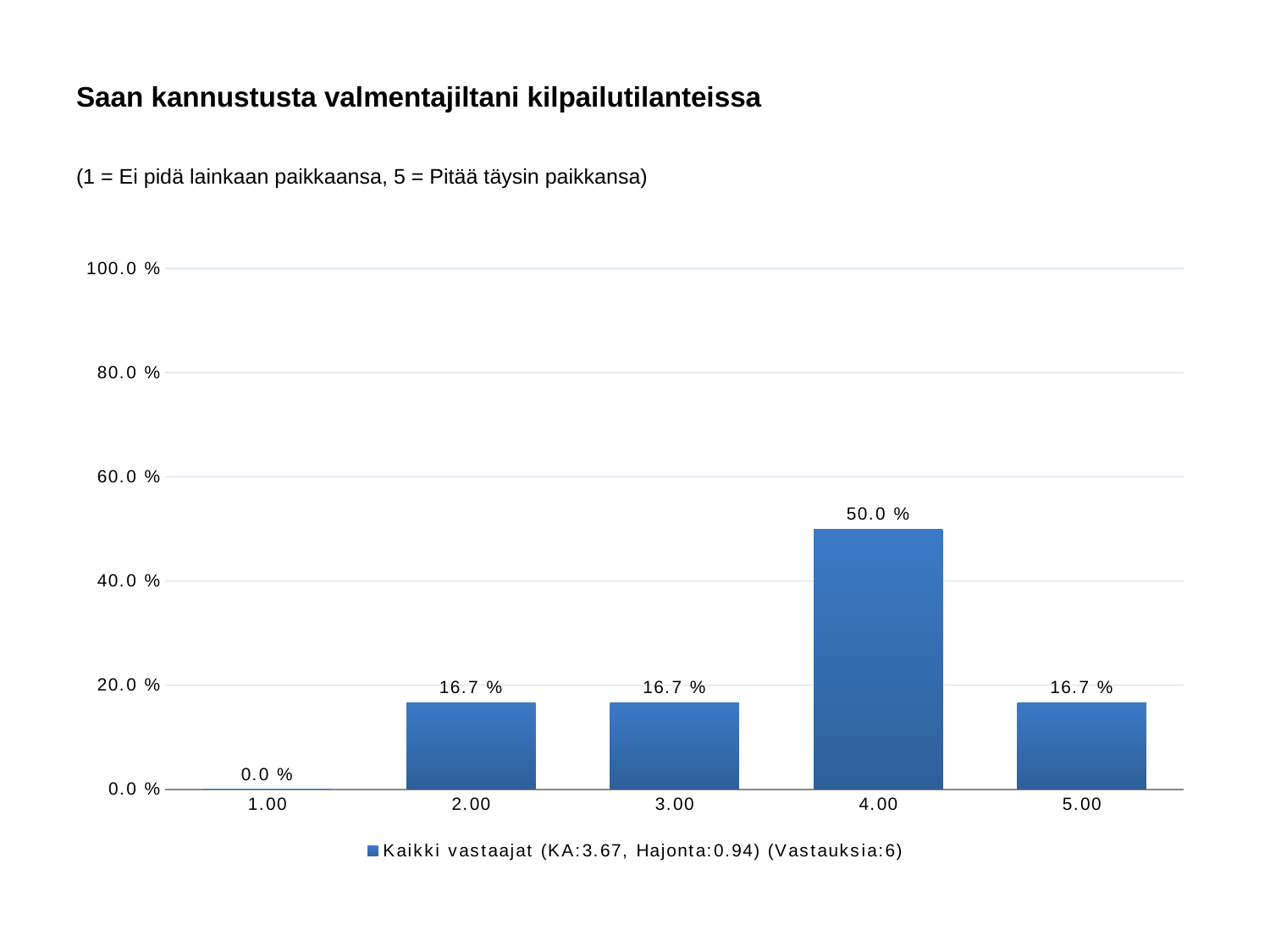
What is the value for category 1.00? 0.0 % Which is larger, the value for 3.00 or the value for 4.00? 4.00 What is the value for category 2.00? 16.7 % What is the value for category 4.00? 50.0 % How many series does the legend list? 1 Which category has the highest value? 4.00 What kind of chart is shown? bar chart What is the legend entry for the series? Kaikki vastaajat (KA:3.67, Hajonta:0.94) (Vastauksia:6) Which category has the lowest value? 1.00 How many categories are shown on the x axis? 5 What is the difference between the values for 4.00 and 5.00? 33.3 % Is the value for 4.00 greater or less than 40.0 %? greater